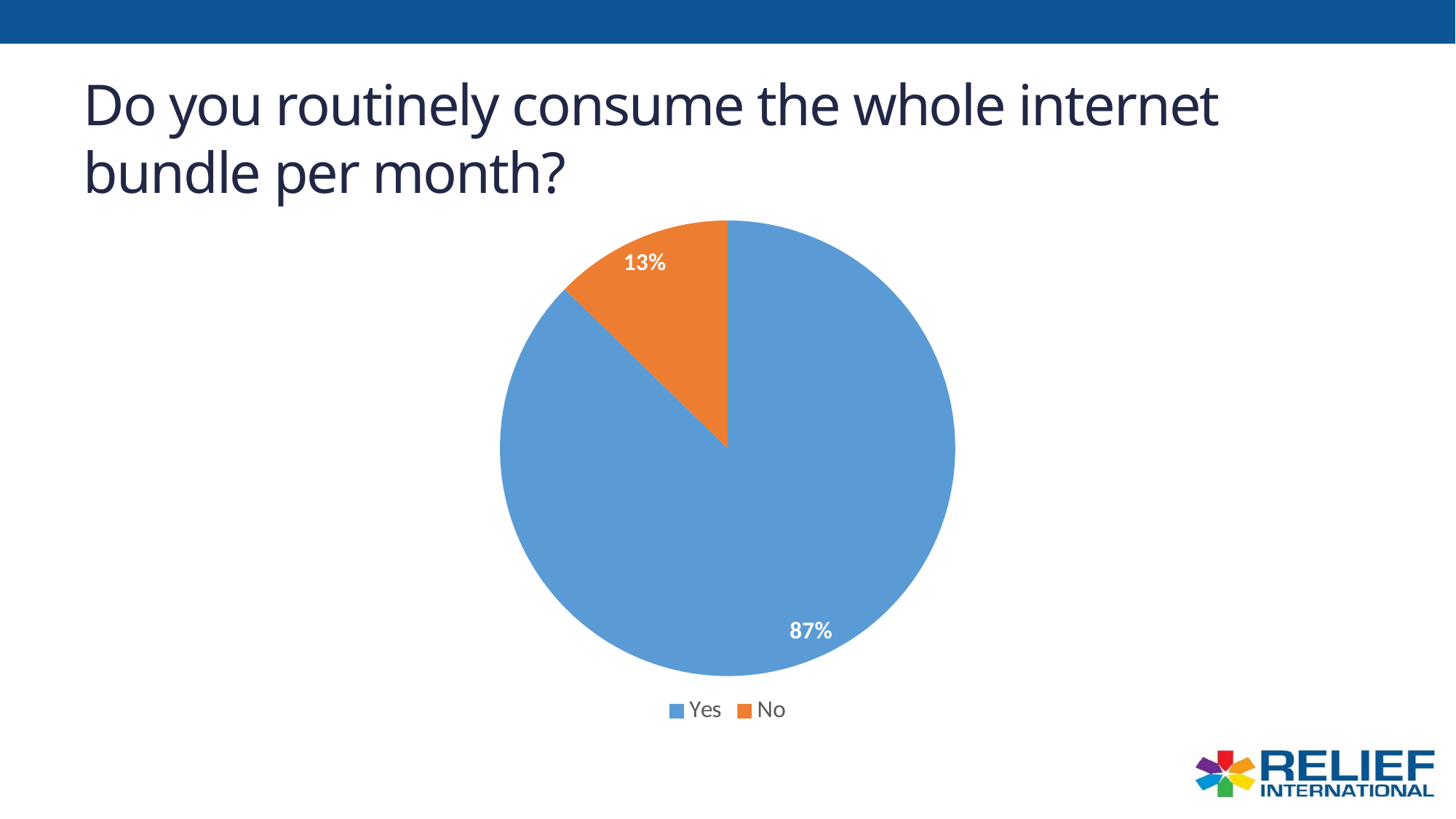
What share of the pie does the No slice represent? 13% Which response has the largest share of the pie? Yes What colour is the Yes slice? Blue What is the difference in percentage points between the Yes and No shares? 74 What question does the slide title ask? Do you routinely consume the whole internet bundle per month? What percentage of respondents answered Yes? 87% What kind of chart is shown on the slide? Pie chart Which is larger, the share for Yes or the share for No? Yes Which response has the smallest share of the pie? No What percentage of respondents answered No? 13% How many slices does the pie chart have? 2 How many entries does the legend list? 2